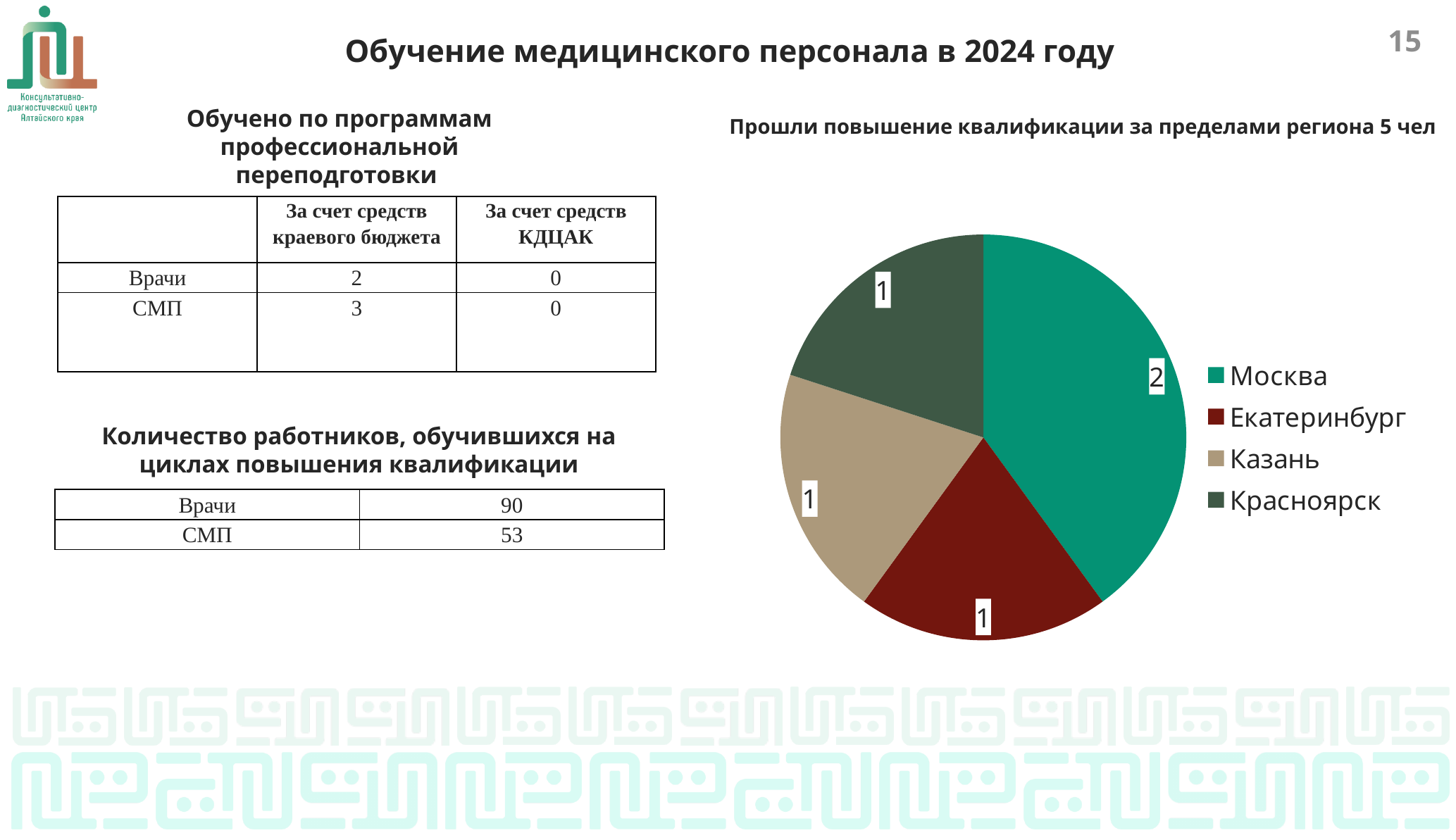
What share of the pie does Москва represent? 40% Which entries are listed in the pie chart's legend? Москва, Екатеринбург, Казань, Красноярск What is the value for Екатеринбург in the pie chart? 1 What is the value for Казань in the pie chart? 1 Which city has the largest slice in the pie chart? Москва What kind of chart is shown on the slide? pie chart Which is larger in the pie chart, Москва or Казань? Москва What is the total of all slices in the pie chart? 5 What is the value for Москва in the pie chart? 2 What is the difference between the values for Москва and Екатеринбург? 1 How many slices does the pie chart have? 4 What is the value for Красноярск in the pie chart? 1